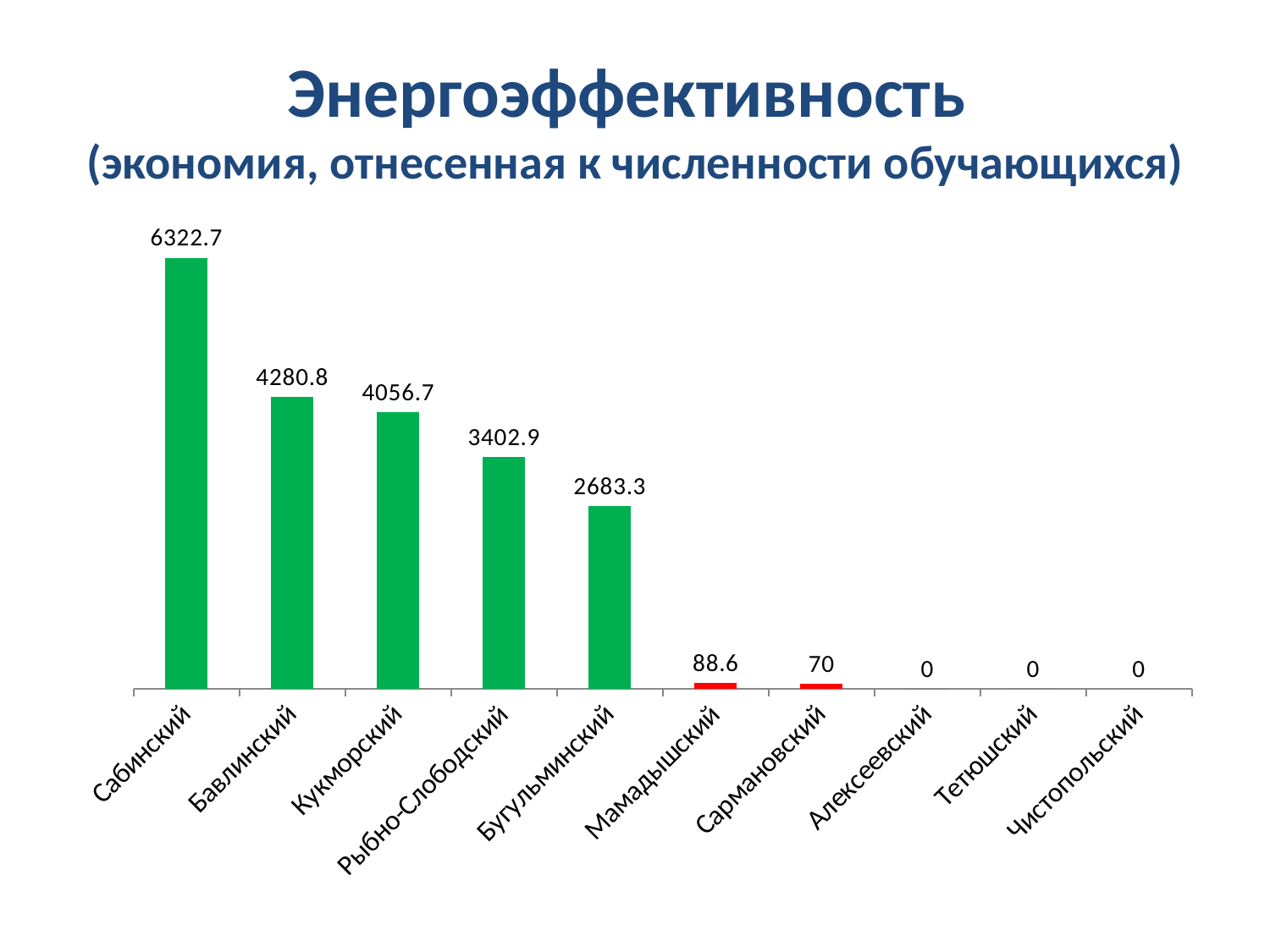
What is the difference between the values for Сабинский and Бугульминский? 3639.4 What is the value for Сабинский? 6322.7 What is the value for Рыбно-Слободский? 3402.9 What is the difference between the values for Бавлинский and Кукморский? 224.1 What is the value for Мамадышский? 88.6 How many categories have a value of 0? 3 What kind of chart is shown on the slide? Bar chart How many categories are shown on the x axis? 10 What is the value for Сармановский? 70 Do the values rise or fall from left to right along the x axis? Fall Which category has the highest value? Сабинский Which is larger, the value for Кукморский or the value for Рыбно-Слободский? Кукморский